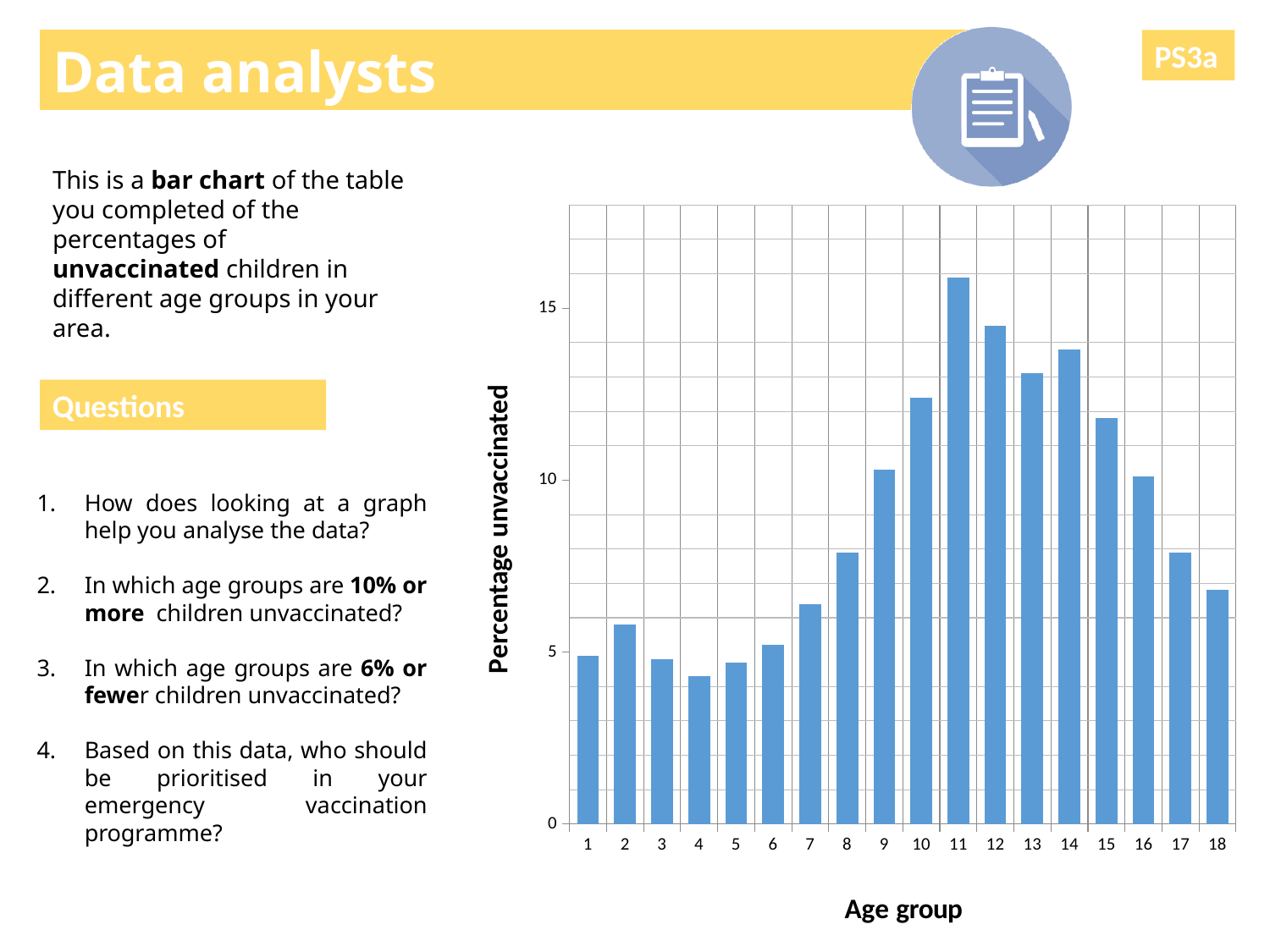
How many age groups are plotted on the x axis of the chart? 18 Is the percentage unvaccinated for age group 11 greater or less than 15? greater What is the title of the vertical axis of the chart? Percentage unvaccinated Is the percentage unvaccinated for age group 4 greater or less than 5? less Which age group has the lowest percentage unvaccinated? 4 Is the percentage unvaccinated for age group 13 greater or less than 10? greater What kind of chart is shown on the slide? bar chart Which has a higher percentage unvaccinated, age group 10 or age group 15? 10 Do the bars rise or fall from age group 11 to age group 18? fall Which age group has the highest percentage unvaccinated? 11 Which has a higher percentage unvaccinated, age group 11 or age group 12? 11